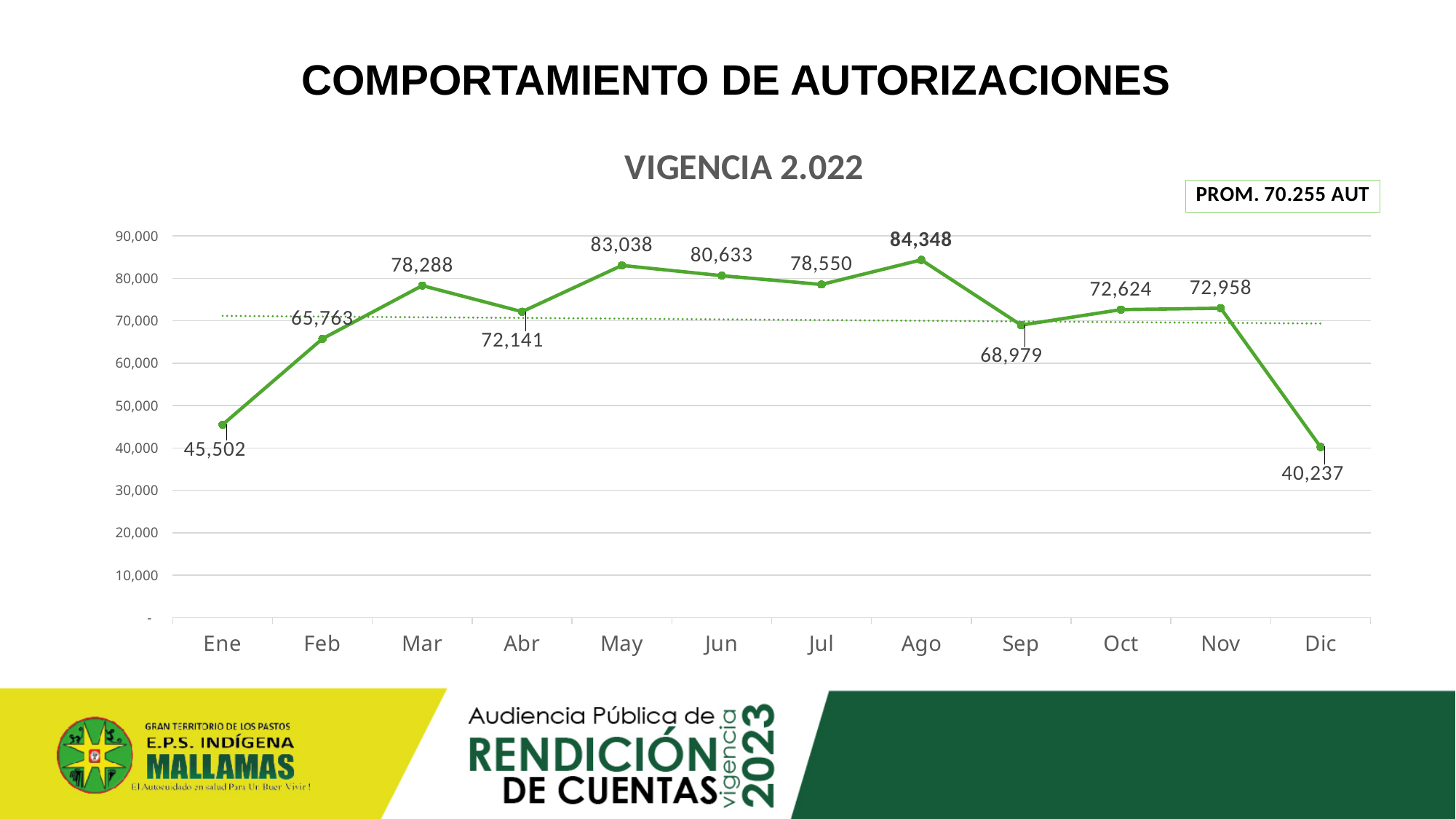
What is the value for Sep? 68,979 Which is larger, the value for May or the value for Jun? May How many months are plotted on the x axis? 12 Which month has the highest value? Ago What average value is shown in the box at the top right of the chart? PROM. 70.255 AUT What is the difference between the values for Ago and Dic? 44,111 What is the chart's title? VIGENCIA 2.022 Is the value for Ene greater or less than 50,000? less Which month has the lowest value? Dic Do the values rise or fall from Ene to Mar? rise What kind of chart is shown? line chart What is the value for Mar? 78,288